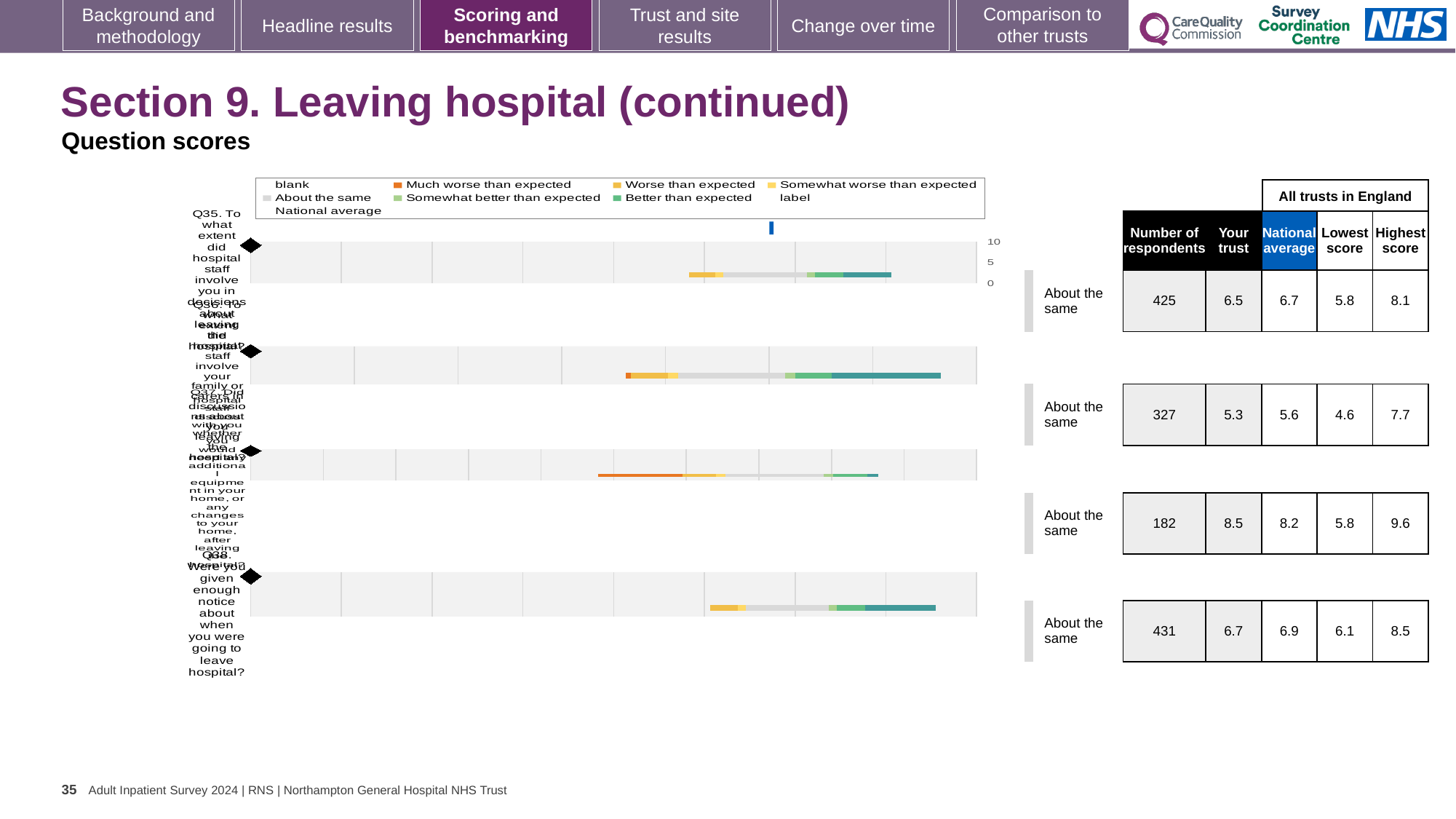
Which question row has the lowest 'Your trust' score in the table? the second row (327 respondents), 5.3 What kind of chart is used to show the question scores on this slide? bar chart What is the national average score for Q35 (involving you in decisions about leaving hospital)? 6.7 How many question rows are plotted in the chart on this slide? 4 How many respondents answered Q38 (given enough notice about when you were going to leave hospital)? 431 What benchmark category is shown for all four questions on this slide? About the same Which question row has the highest 'Your trust' score in the table? the third row (182 respondents), 8.5 In the legend, which entry is shown in dark orange? Much worse than expected What is the highest score among all trusts in England for Q38 (given enough notice about leaving hospital)? 8.5 What is the 'Your trust' score for Q35 (involving you in decisions about leaving hospital)? 6.5 What is the highest value shown on the chart's horizontal axis? 10 What is the difference between the national average and the 'Your trust' score for Q35? 0.2